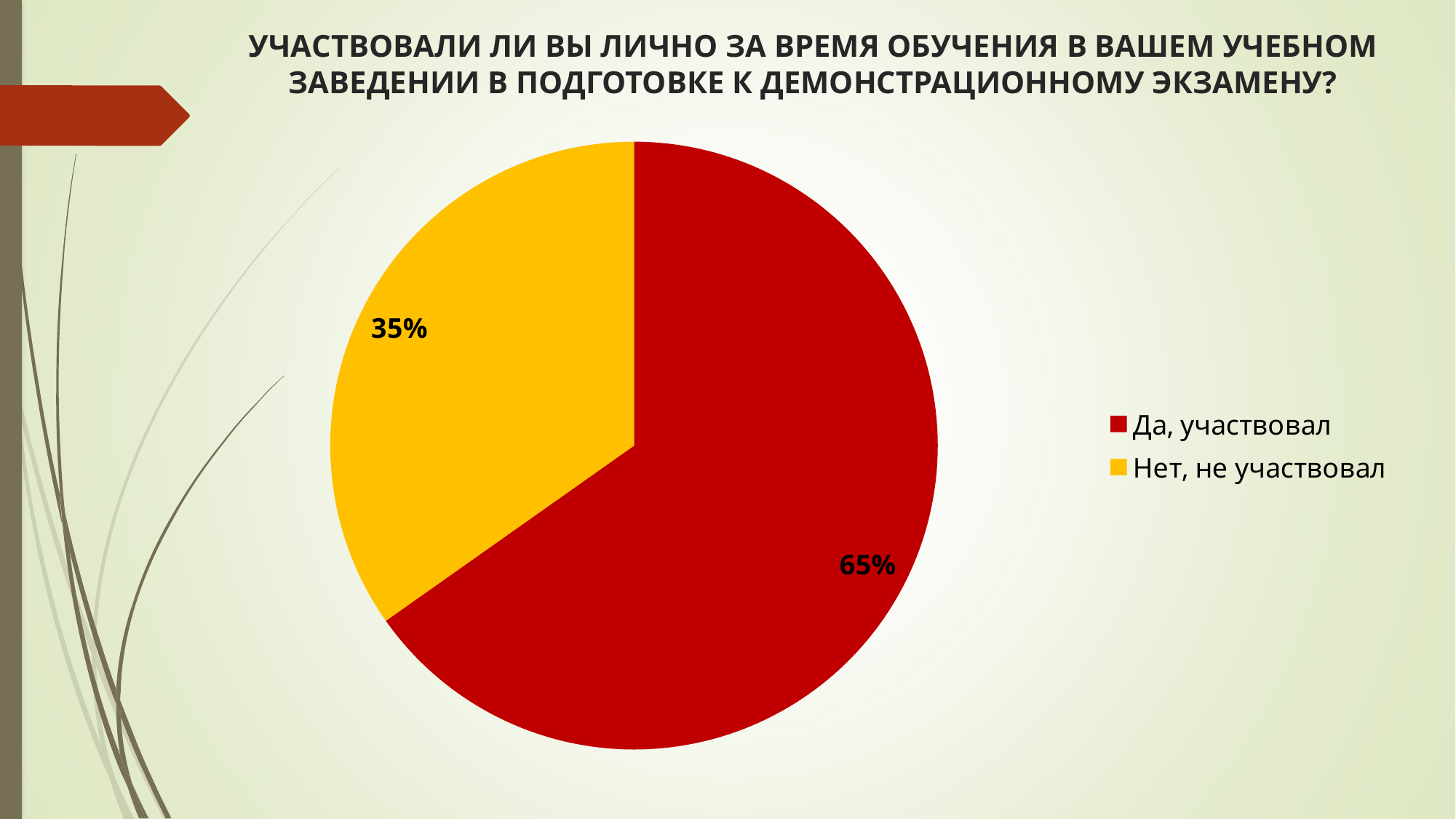
What share of the pie does "Да, участвовал" represent? 65% How many categories are shown in the pie chart? 2 Which is larger: the slice for "Да, участвовал" or the slice for "Нет, не участвовал"? Да, участвовал What colour is the slice for "Да, участвовал"? Red What is the difference in percentage points between "Да, участвовал" and "Нет, не участвовал"? 30% What colour is the slice for "Нет, не участвовал"? Yellow Which category has the smallest slice of the pie? Нет, не участвовал How many entries does the legend list? 2 What share of the pie does "Нет, не участвовал" represent? 35% Which category has the largest slice of the pie? Да, участвовал What type of chart is shown on the slide? Pie chart